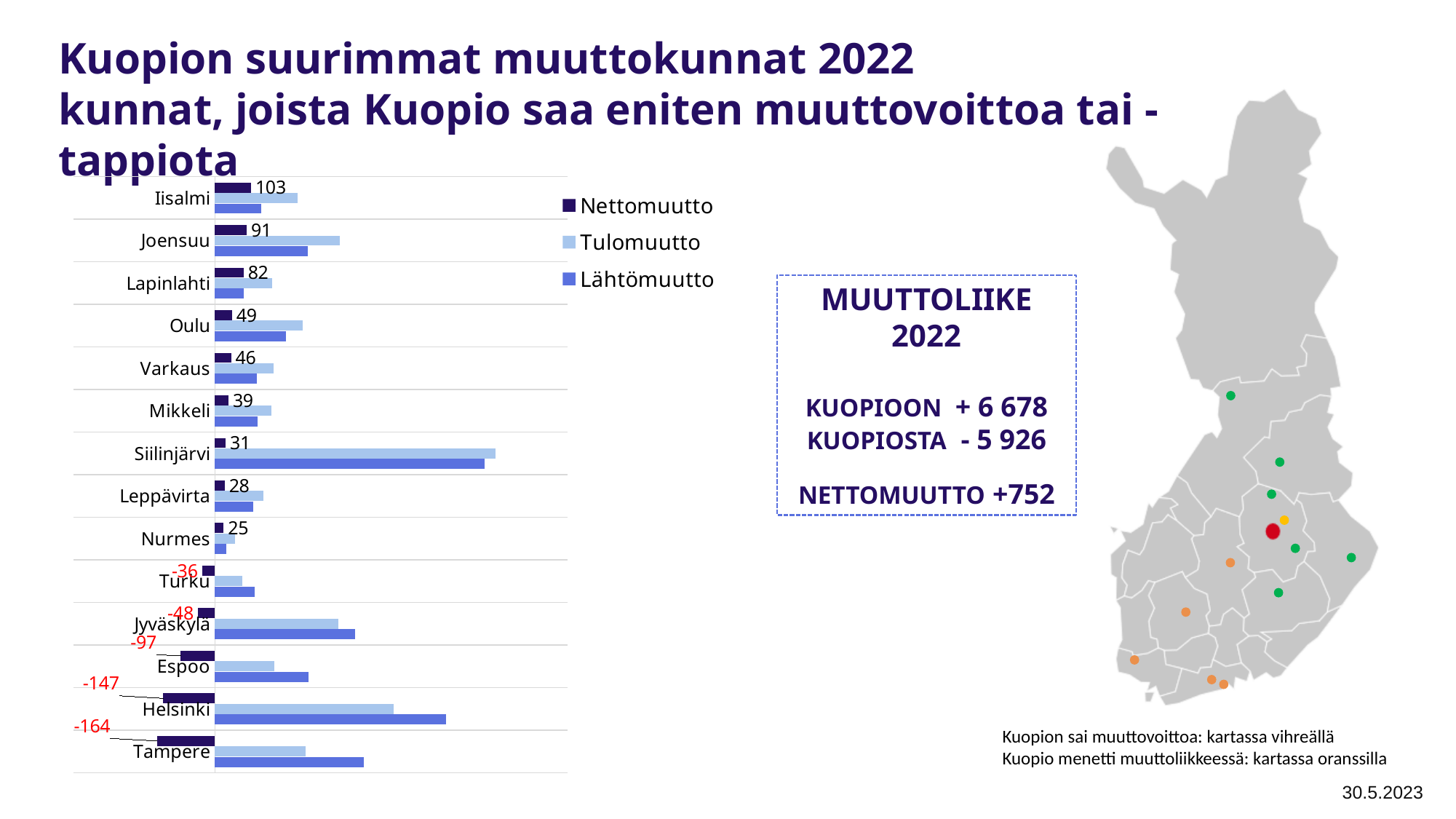
Which municipality has the lowest Nettomuutto value? Tampere For Helsinki, which is larger: Tulomuutto or Lähtömuutto? Lähtömuutto What is the Nettomuutto value for Tampere? -164 How many series does the legend list? 3 Which municipality has the highest Nettomuutto value? Iisalmi Which municipality has the longest Tulomuutto bar? Siilinjärvi What is the difference between the Nettomuutto values for Iisalmi and Joensuu? 12 What is the Nettomuutto value for Espoo? -97 How many municipalities are shown in the chart? 14 What is the Nettomuutto value for Siilinjärvi? 31 What is the Nettomuutto value for Iisalmi? 103 What kind of chart is shown on the slide? Bar chart